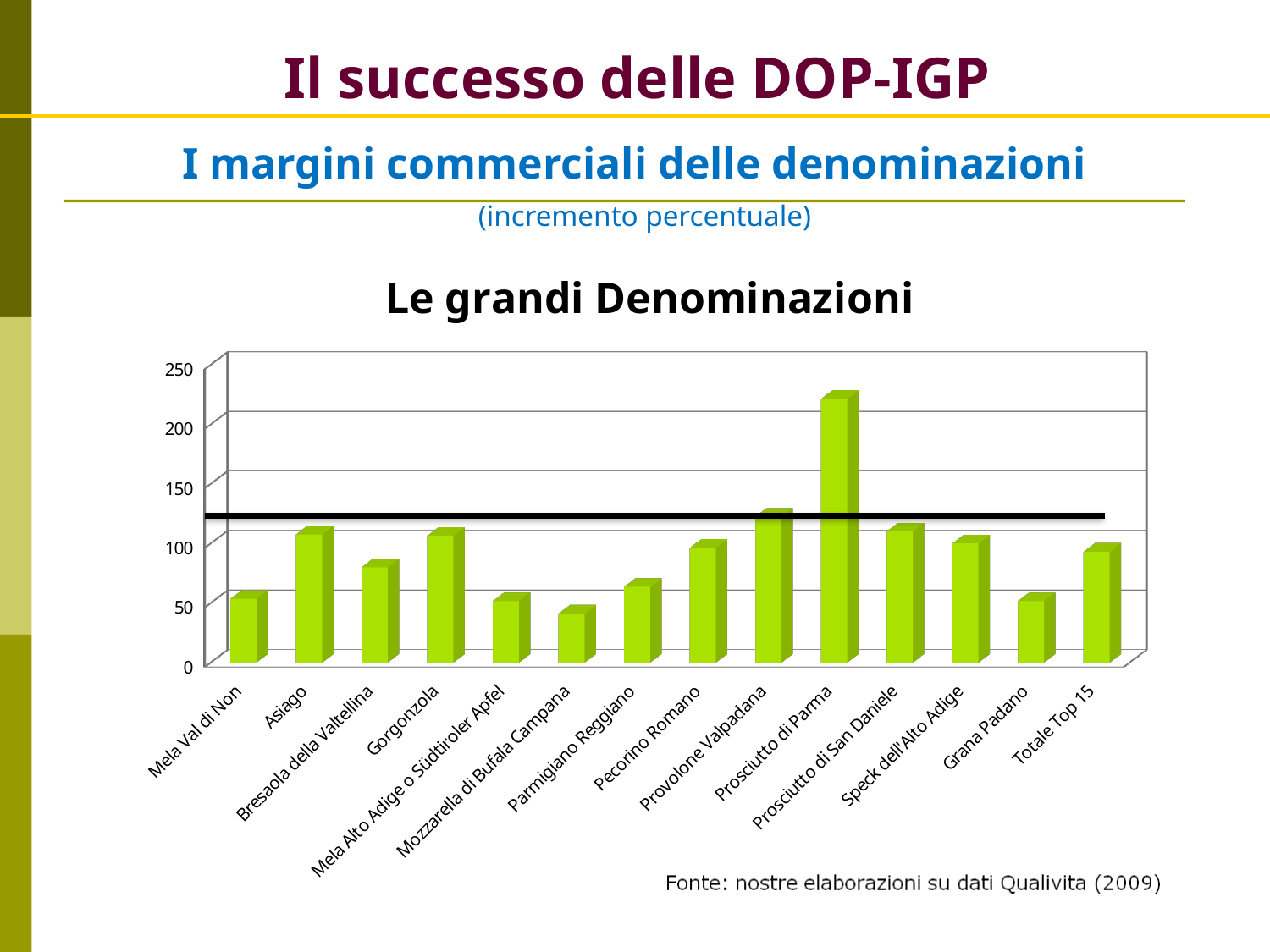
Which category has the lowest bar in the chart? Mozzarella di Bufala Campana What is the title of the chart? Le grandi Denominazioni Which category has the highest bar in the chart? Prosciutto di Parma Is the value for Prosciutto di Parma greater or less than 200? greater Is the value for Bresaola della Valtellina greater or less than 100? less Which is larger, the value for Pecorino Romano or the value for Mozzarella di Bufala Campana? Pecorino Romano Is the value for Mozzarella di Bufala Campana greater or less than 50? less Which is larger, the value for Prosciutto di Parma or the value for Asiago? Prosciutto di Parma According to the note below the chart, what is the data source? nostre elaborazioni su dati Qualivita (2009) How many categories are plotted on the x axis of the chart? 14 What kind of chart is shown on the slide? bar chart